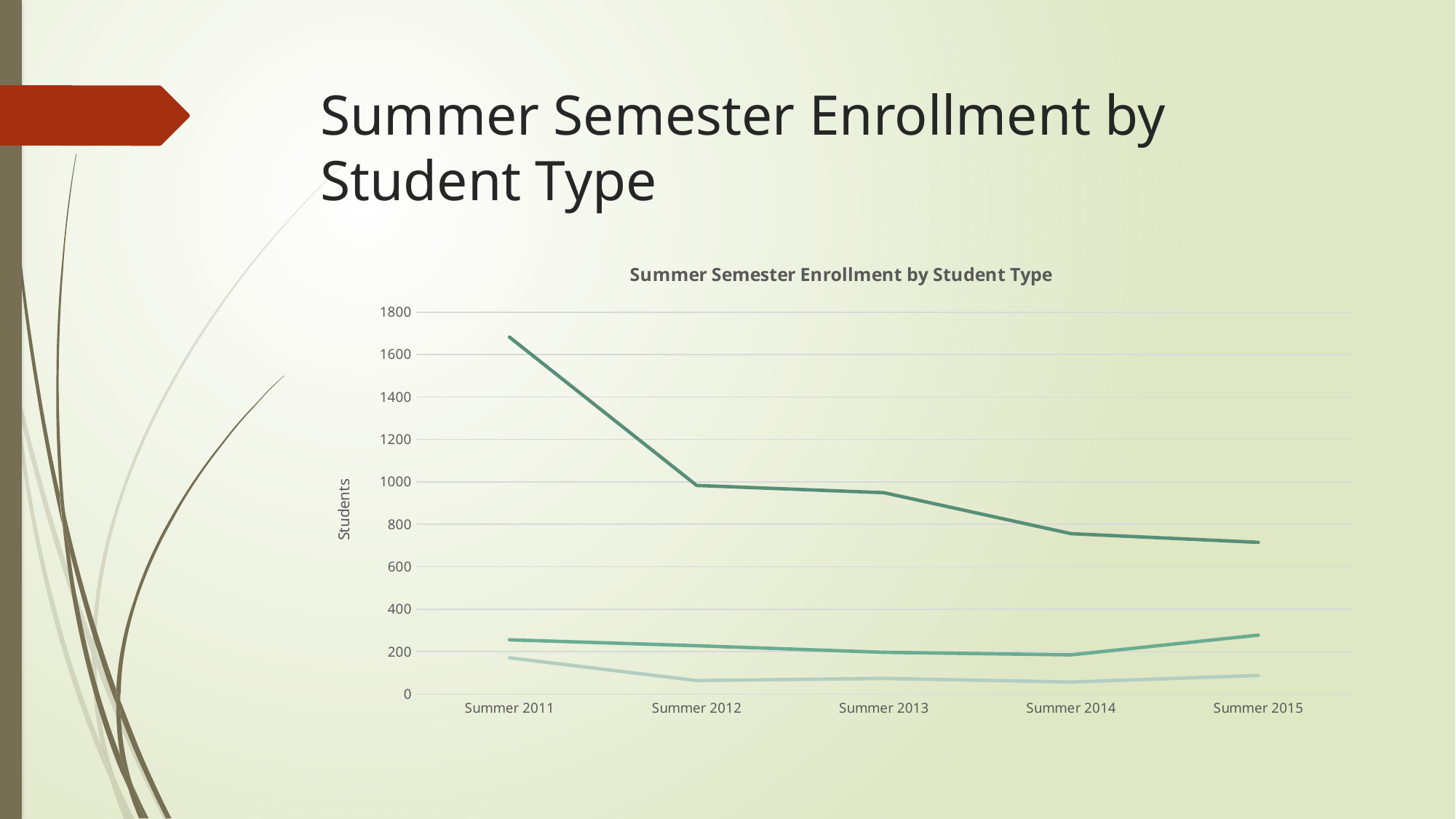
Does the top (highest) line rise or fall from Summer 2011 to Summer 2015? Fall Is the value of the top line for Summer 2014 greater or less than 800? less Is the value of the middle line for Summer 2015 greater or less than 200? greater In which semester does the top line reach its lowest value? Summer 2015 Is the value of the top line for Summer 2011 greater or less than 1600? greater What is the title of the chart? Summer Semester Enrollment by Student Type What is the label on the vertical axis? Students In which semester does the top line reach its highest value? Summer 2011 How many summer semesters are shown on the x axis? 5 For the top line, which is larger: the value for Summer 2011 or the value for Summer 2012? Summer 2011 How many lines are plotted on the chart? 3 What type of chart is shown on the slide? Line chart